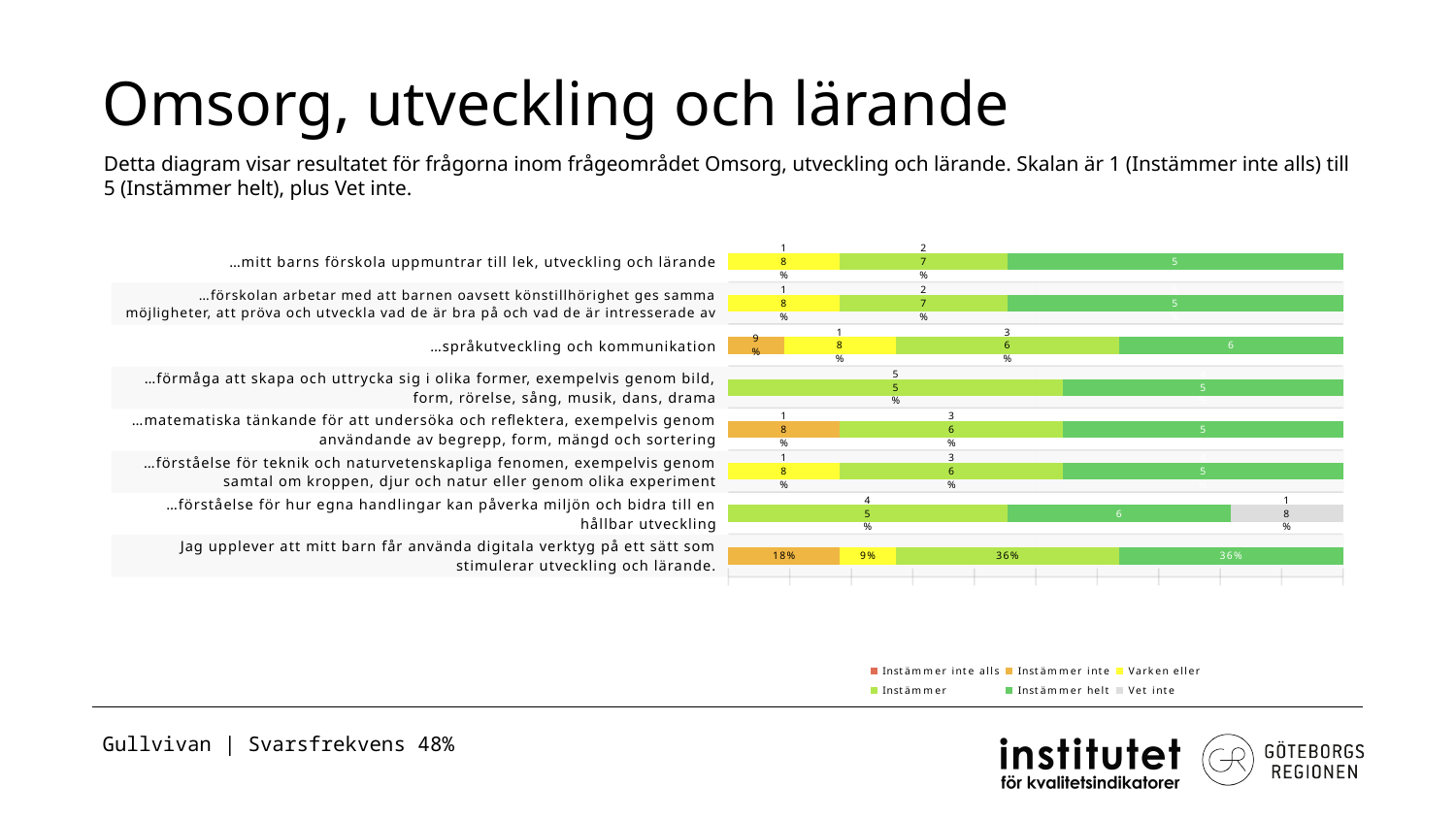
What kind of chart is shown on the slide? Stacked horizontal bar chart For the statement 'Jag upplever att mitt barn får använda digitala verktyg på ett sätt som stimulerar utveckling och lärande', what is the share for 'Varken eller'? 9% How many question statements (categories) are plotted in the chart? 8 For the statement 'Jag upplever att mitt barn får använda digitala verktyg på ett sätt som stimulerar utveckling och lärande', what is the share for 'Instämmer helt'? 36% For the statement 'Jag upplever att mitt barn får använda digitala verktyg på ett sätt som stimulerar utveckling och lärande', what is the share for 'Instämmer'? 36% How many series does the legend list? 6 Which statement is the only one with a 'Vet inte' segment in its bar? ...förståelse för hur egna handlingar kan påverka miljön och bidra till en hållbar utveckling For the statement '...språkutveckling och kommunikation', what is the share for 'Instämmer inte'? 9% What colour represents 'Vet inte' in the legend? Grey